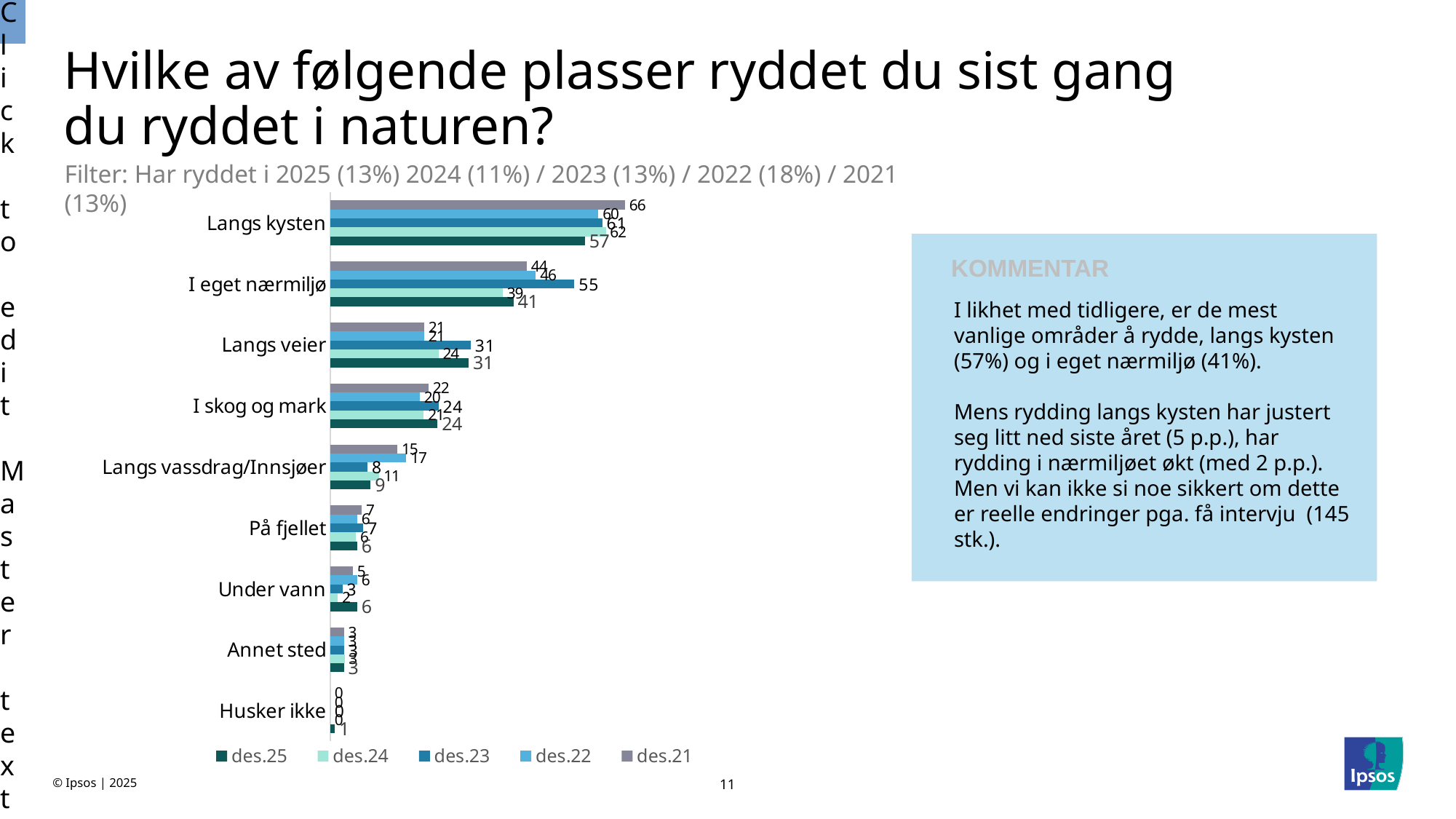
What is the des.21 value for "Langs kysten"? 66 What is the des.25 value for "I eget nærmiljø"? 41 For des.25, which is larger: "Langs veier" or "I skog og mark"? Langs veier What is the des.23 value for "I eget nærmiljø"? 55 What is the difference between the des.21 and des.25 values for "Langs kysten"? 9 How many categories are shown on the chart? 9 What is the des.25 value for "Langs kysten"? 57 What kind of chart is shown on the slide? Bar chart Which category has the highest des.25 value? Langs kysten Which series is shown in dark teal in the legend? des.25 Which category has the lowest des.25 value? Husker ikke How many series does the legend list? 5